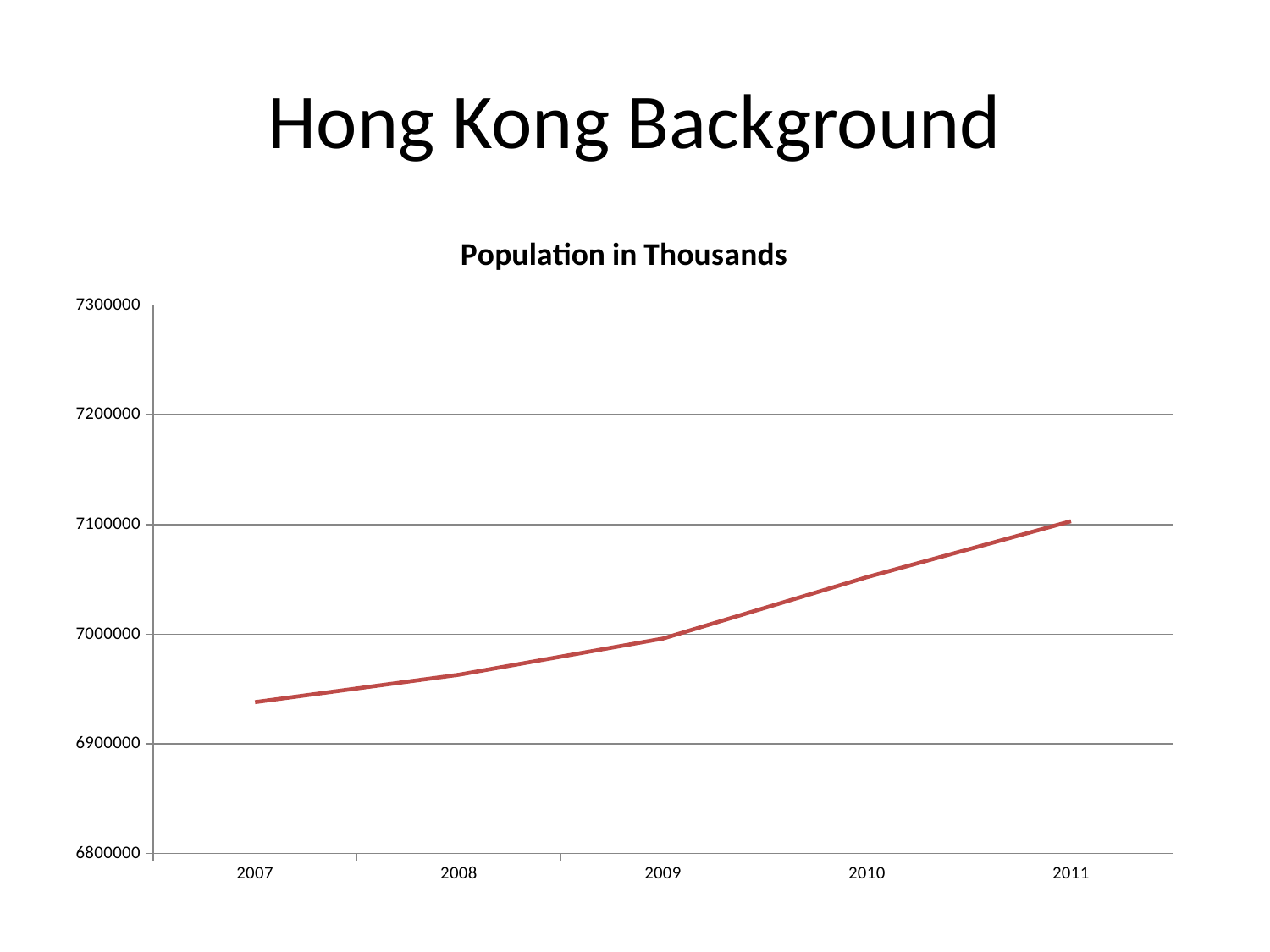
How many years are plotted on the x axis of the chart? 5 What kind of chart is shown on the slide? line chart Is the value for 2007 greater or less than 6900000? greater What is the title of the chart? Population in Thousands Is the value for 2008 greater or less than 7000000? less Which year has the lowest population value in the chart? 2007 Is the value for 2011 greater or less than 7200000? less Do the population values rise or fall from 2007 to 2011? rise What is the lowest value shown on the y axis of the chart? 6800000 Which year has the larger population value, 2008 or 2010? 2010 Which year has the highest population value in the chart? 2011